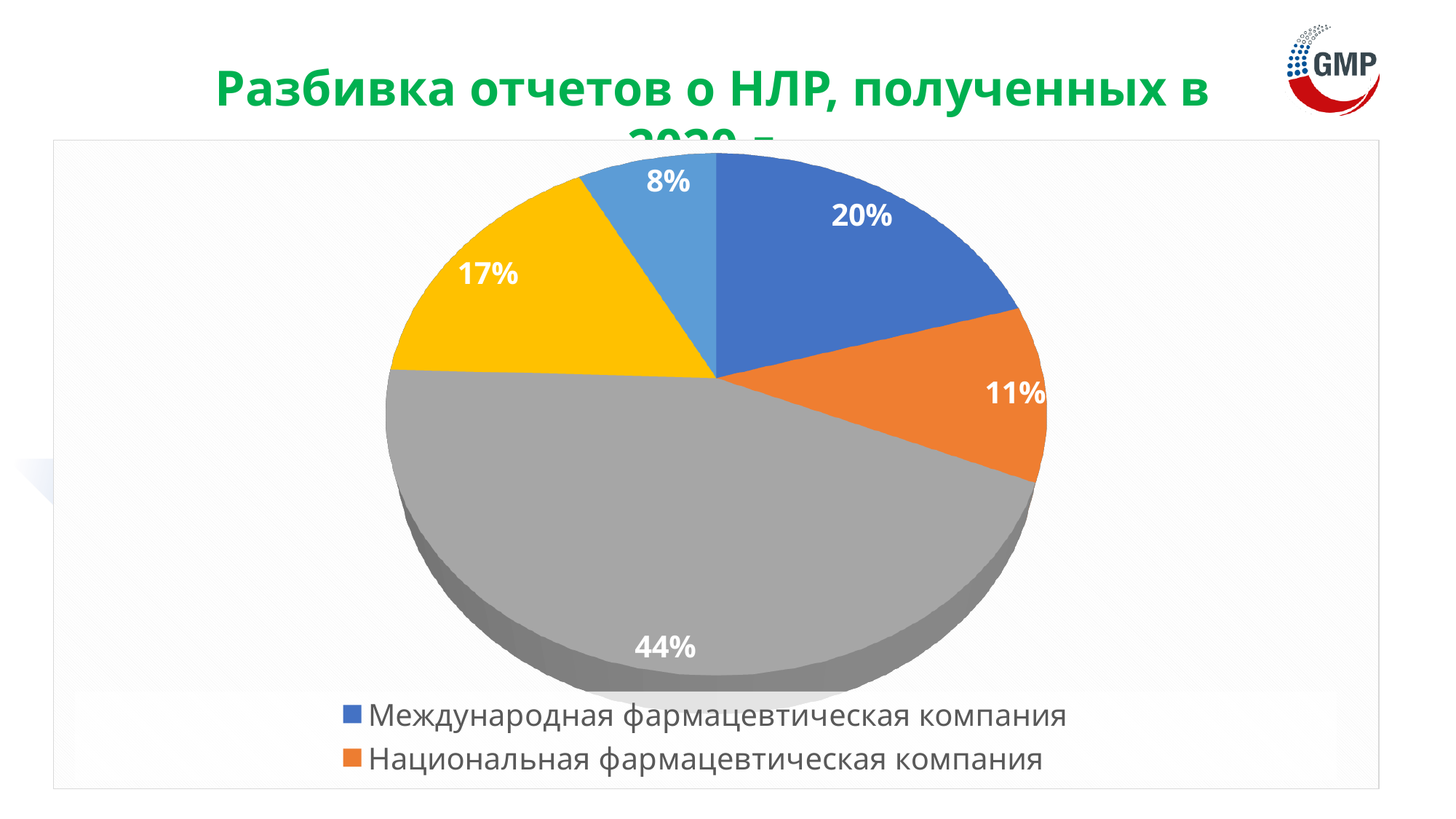
What is the value of the largest slice in the pie chart? 44% What share of the pie does Национальная фармацевтическая компания account for? 11% By how many percentage points does the Международная фармацевтическая компания slice exceed the Национальная фармацевтическая компания slice? 9 percentage points What share of the pie does Международная фармацевтическая компания account for? 20% Which is larger: the slice for Международная фармацевтическая компания or the slice for Национальная фармацевтическая компания? Международная фармацевтическая компания How many slices does the pie chart have? 5 What kind of chart is shown on the slide? Pie chart What colour is the largest slice of the pie chart? Gray How many entries are shown in the chart legend? 2 What is the value of the smallest slice in the pie chart? 8% What colour is the slice for Национальная фармацевтическая компания? Orange What is the value of the yellow slice in the pie chart? 17%